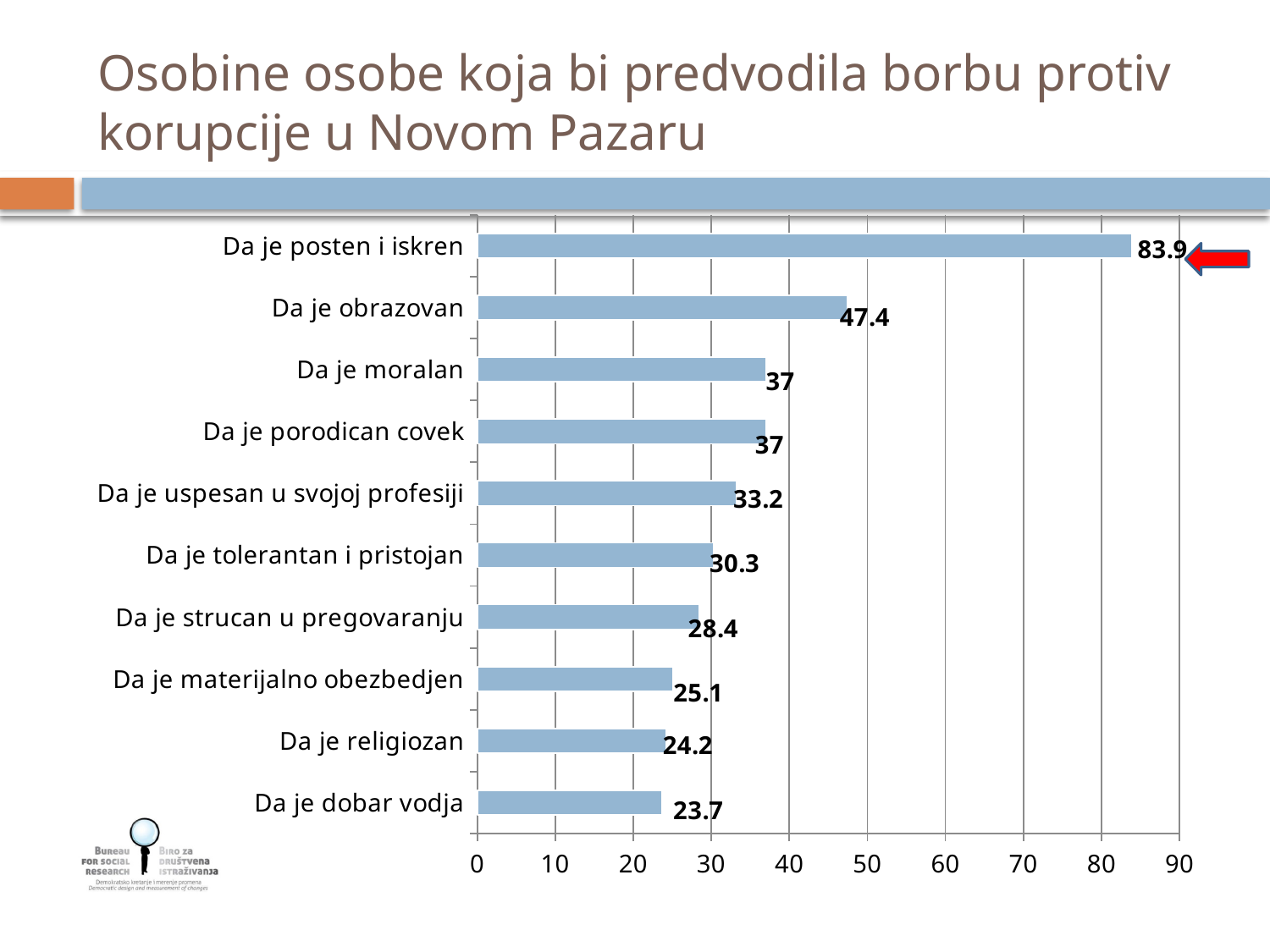
Which category has the highest value? Da je posten i iskren What is the value for "Da je tolerantan i pristojan"? 30.3 What is the value for "Da je posten i iskren"? 83.9 Is the value for "Da je uspesan u svojoj profesiji" greater or less than 30? greater What is the difference between the values for "Da je posten i iskren" and "Da je obrazovan"? 36.5 What is the value for "Da je obrazovan"? 47.4 What kind of chart is shown on the slide? bar chart How many categories are shown in the chart? 10 Which is larger, the value for "Da je strucan u pregovaranju" or the value for "Da je materijalno obezbedjen"? Da je strucan u pregovaranju What is the title of the slide? Osobine osobe koja bi predvodila borbu protiv korupcije u Novom Pazaru What is the value for "Da je religiozan"? 24.2 Which category has the lowest value? Da je dobar vodja